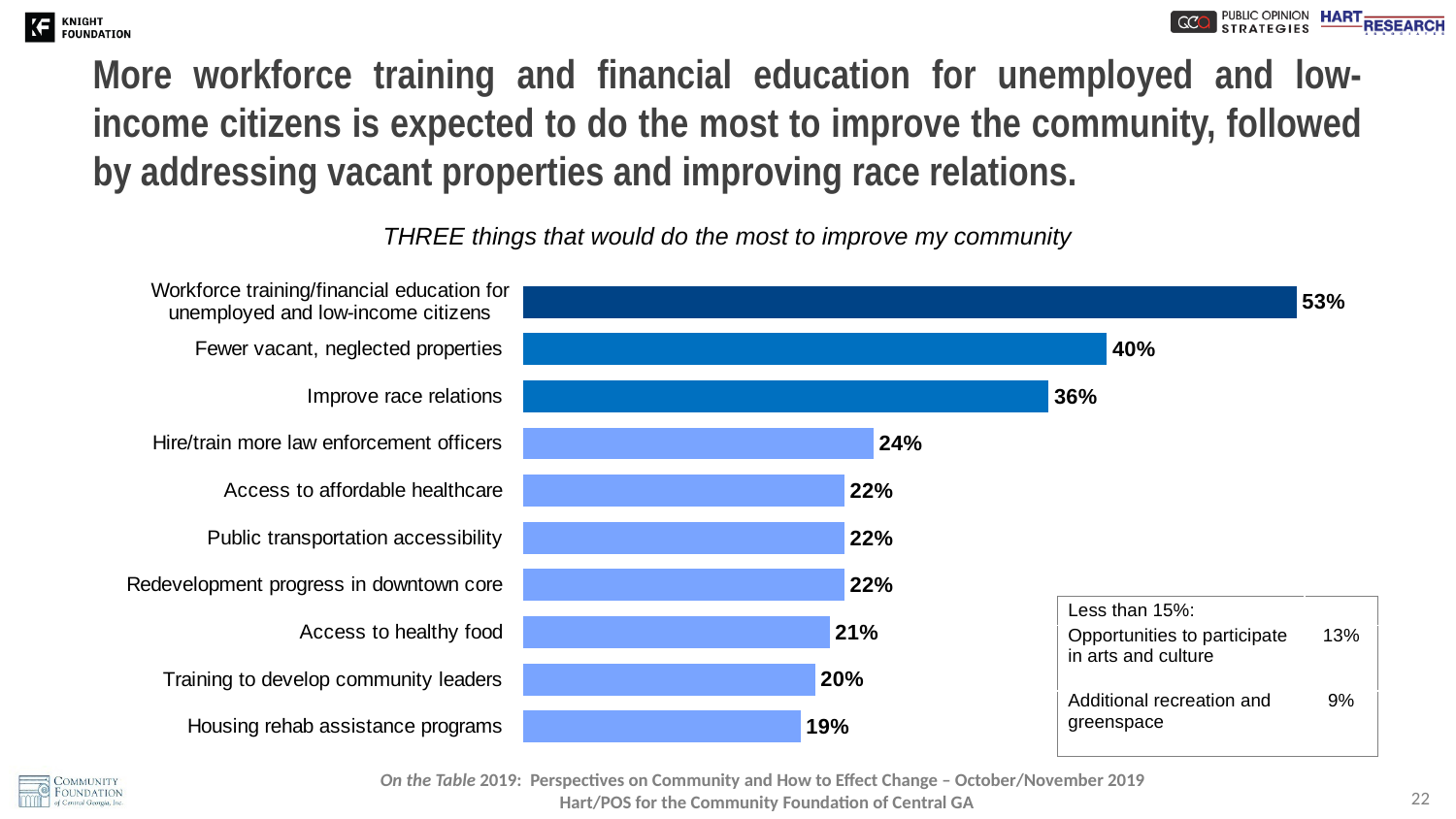
Which category has the highest value in the chart? Workforce training/financial education for unemployed and low-income citizens What is the difference between 'Fewer vacant, neglected properties' and 'Improve race relations'? 4% Which is larger: 'Access to healthy food' or 'Training to develop community leaders'? Access to healthy food Which of the plotted bars has the lowest value? Housing rehab assistance programs What is the difference between the highest bar and 'Hire/train more law enforcement officers'? 29% What is the value for 'Improve race relations'? 36% What kind of chart is shown on the slide? Bar chart What is the value for 'Housing rehab assistance programs'? 19% What is the subtitle of the chart? THREE things that would do the most to improve my community What percentage of respondents chose workforce training/financial education for unemployed and low-income citizens? 53% According to the 'Less than 15%' box, what percentage chose 'Additional recreation and greenspace'? 9% How many categories are plotted as bars in the chart? 10